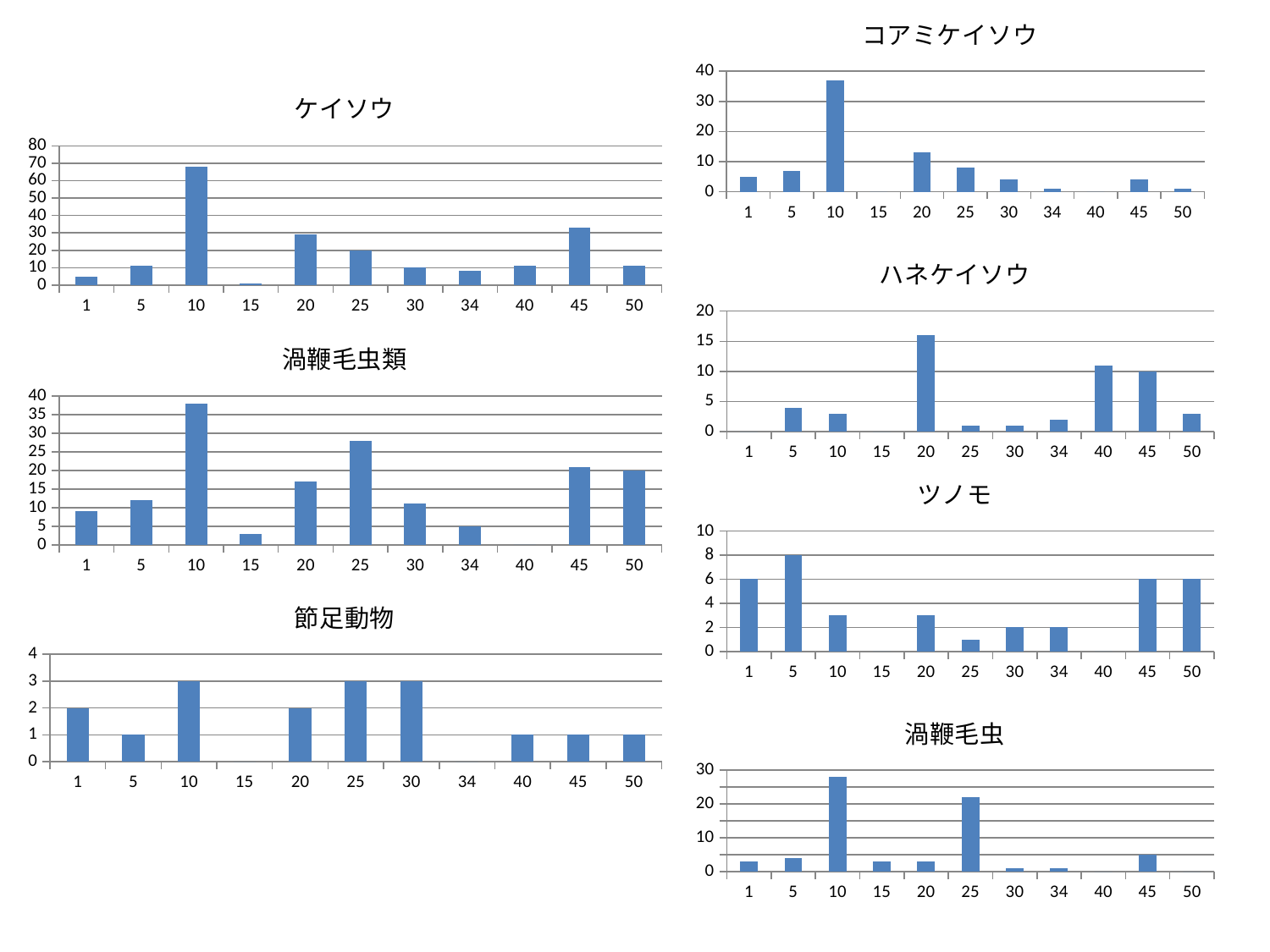
In the ケイソウ chart, is the value for category 10 greater or less than 60? greater In the 渦鞭毛虫 chart, is the value for category 25 greater or less than 20? greater In the ツノモ chart, what is the value for category 5? 8 What kind of chart is the ケイソウ chart? bar chart In the ハネケイソウ chart, which category has the highest value? 20 In the 節足動物 chart, how many categories are shown on the x axis? 11 In the 節足動物 chart, what is the value for category 10? 3 How many charts are shown on the slide? 7 In the コアミケイソウ chart, which category has the highest value? 10 In the 渦鞭毛虫類 chart, what is the value for category 50? 20 In the 渦鞭毛虫類 chart, which is larger, the value for category 10 or the value for category 25? 10 In the 節足動物 chart, what is the difference between the value for category 10 and the value for category 5? 2